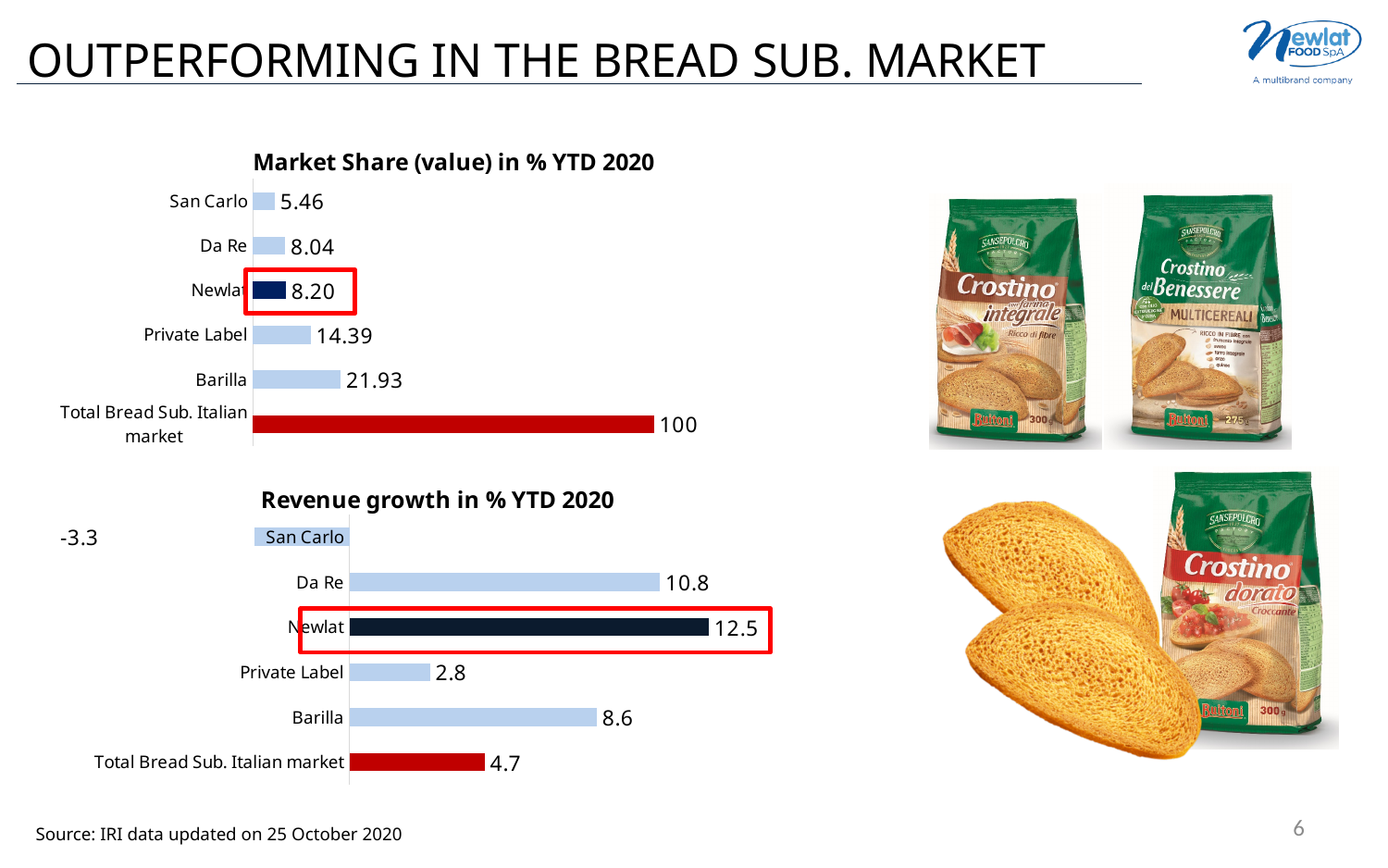
In the 'Market Share (value) in % YTD 2020' chart, what is the value for Newlat? 8.20 In the 'Market Share (value) in % YTD 2020' chart, what is the value for Barilla? 21.93 How many categories are shown in the 'Market Share (value) in % YTD 2020' chart? 6 In the 'Revenue growth in % YTD 2020' chart, which category has the highest revenue growth? Newlat In the 'Revenue growth in % YTD 2020' chart, what is the value for San Carlo? -3.3 In both charts, which category is highlighted with a red box? Newlat In the 'Market Share (value) in % YTD 2020' chart, what is the difference between Barilla and Private Label? 7.54 What type of chart is the 'Revenue growth in % YTD 2020' chart? Bar chart In the 'Market Share (value) in % YTD 2020' chart, which is larger, Da Re or Newlat? Newlat In the 'Market Share (value) in % YTD 2020' chart, which brand (excluding the total market bar) has the lowest market share? San Carlo In the 'Revenue growth in % YTD 2020' chart, what is the difference between Newlat and the Total Bread Sub. Italian market? 7.8 In the 'Revenue growth in % YTD 2020' chart, what is the value for Newlat? 12.5